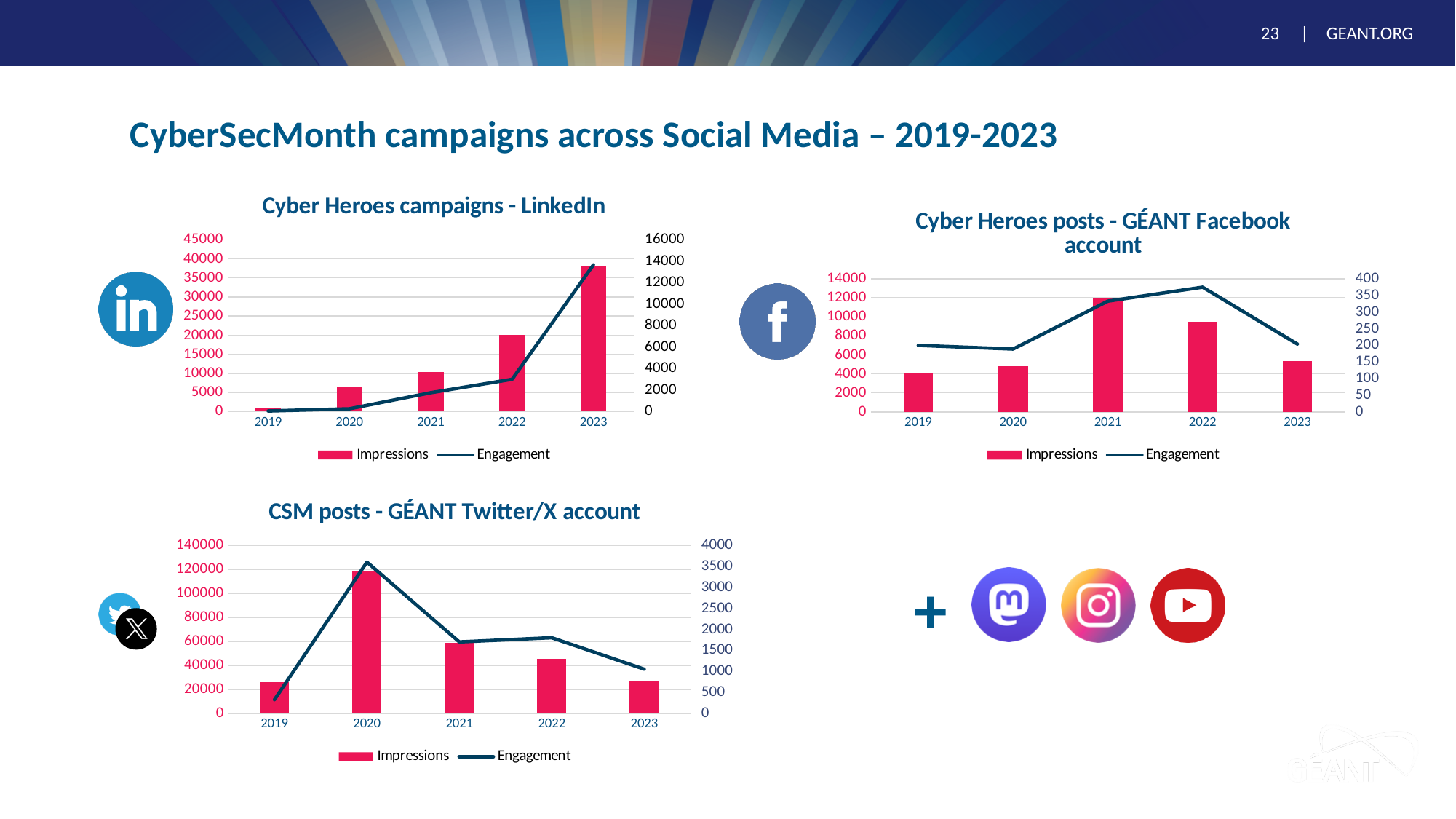
What kind of chart is the 'CSM posts - GÉANT Twitter/X account' chart? Combined bar and line chart In the 'CSM posts - GÉANT Twitter/X account' chart, is the Impressions value for 2020 greater or less than 100000? greater In the 'Cyber Heroes campaigns - LinkedIn' chart, do Impressions rise or fall from 2019 to 2023? rise In the 'Cyber Heroes posts - GÉANT Facebook account' chart, which year has the lowest Impressions? 2019 In the 'CSM posts - GÉANT Twitter/X account' chart, how many years are shown on the x axis? 5 In the 'Cyber Heroes campaigns - LinkedIn' chart, which year has the highest Impressions? 2023 In the 'Cyber Heroes campaigns - LinkedIn' chart, how many series does the legend list? 2 In the 'Cyber Heroes posts - GÉANT Facebook account' chart, which year has the highest Impressions? 2021 In the 'Cyber Heroes posts - GÉANT Facebook account' chart, is the Engagement value for 2022 greater or less than 300? greater In the 'Cyber Heroes campaigns - LinkedIn' chart, is the Impressions value for 2022 greater or less than 15000? greater In the 'Cyber Heroes posts - GÉANT Facebook account' chart, which year has larger Impressions, 2021 or 2022? 2021 In the 'CSM posts - GÉANT Twitter/X account' chart, which year has the highest Impressions? 2020